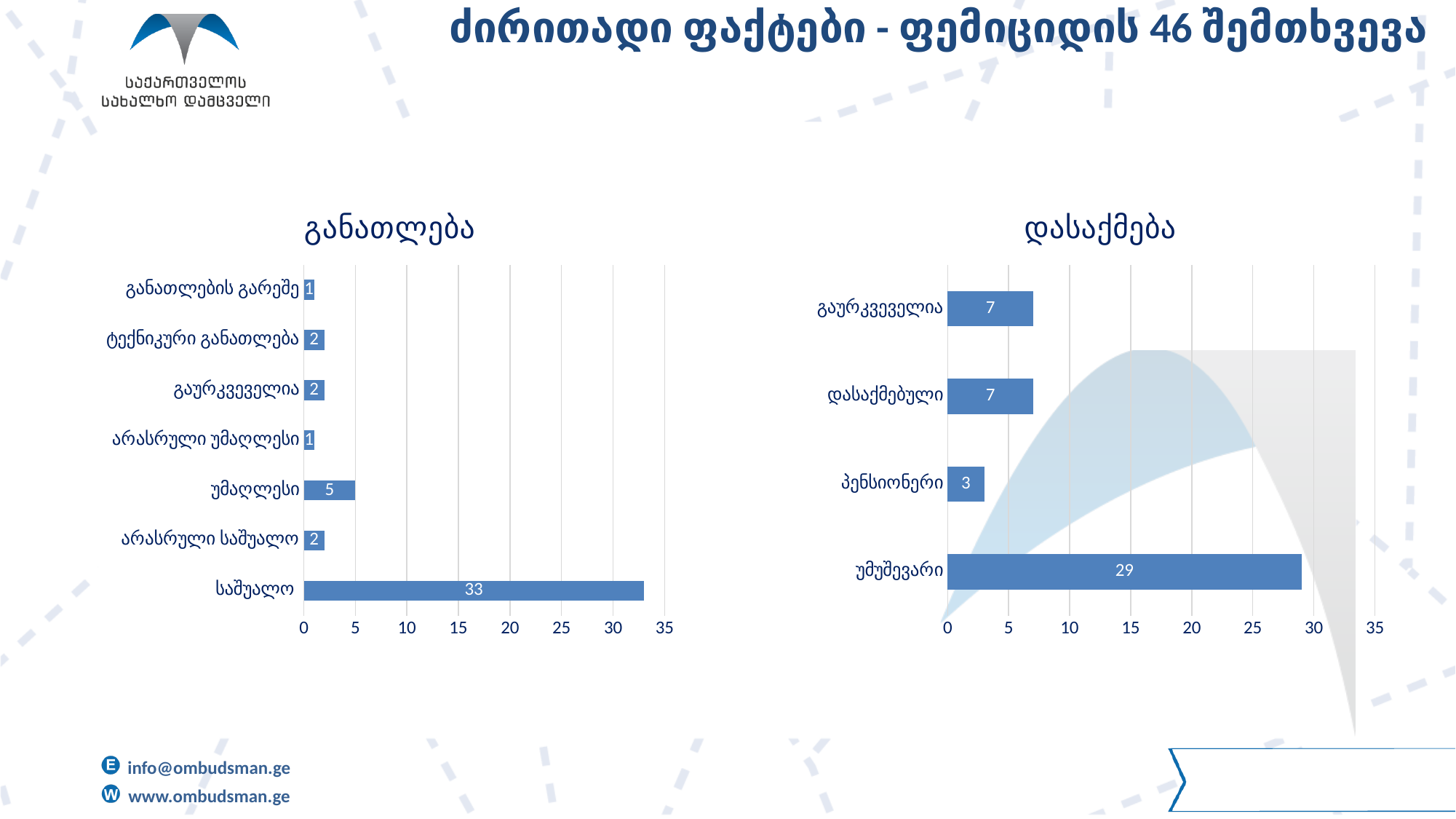
In the chart titled "განათლება", what is the difference between the values for "საშუალო" and "უმაღლესი"? 28 In the chart titled "განათლება", what is the value for "ტექნიკური განათლება"? 2 In the chart titled "განათლება", which category has the highest value? საშუალო In the chart titled "განათლება", what is the value for "უმაღლესი"? 5 In the chart titled "დასაქმება", what is the value for "პენსიონერი"? 3 In the chart titled "დასაქმება", which category has the lowest value? პენსიონერი What type of chart is the chart titled "დასაქმება"? Bar chart In the chart titled "განათლება", what is the value for "საშუალო"? 33 In the chart titled "დასაქმება", which is larger: the value for "დასაქმებული" or the value for "პენსიონერი"? დასაქმებული In the chart titled "დასაქმება", what is the value for "უმუშევარი"? 29 In the chart titled "განათლება", how many categories are shown? 7 In the chart titled "დასაქმება", how many categories are shown? 4